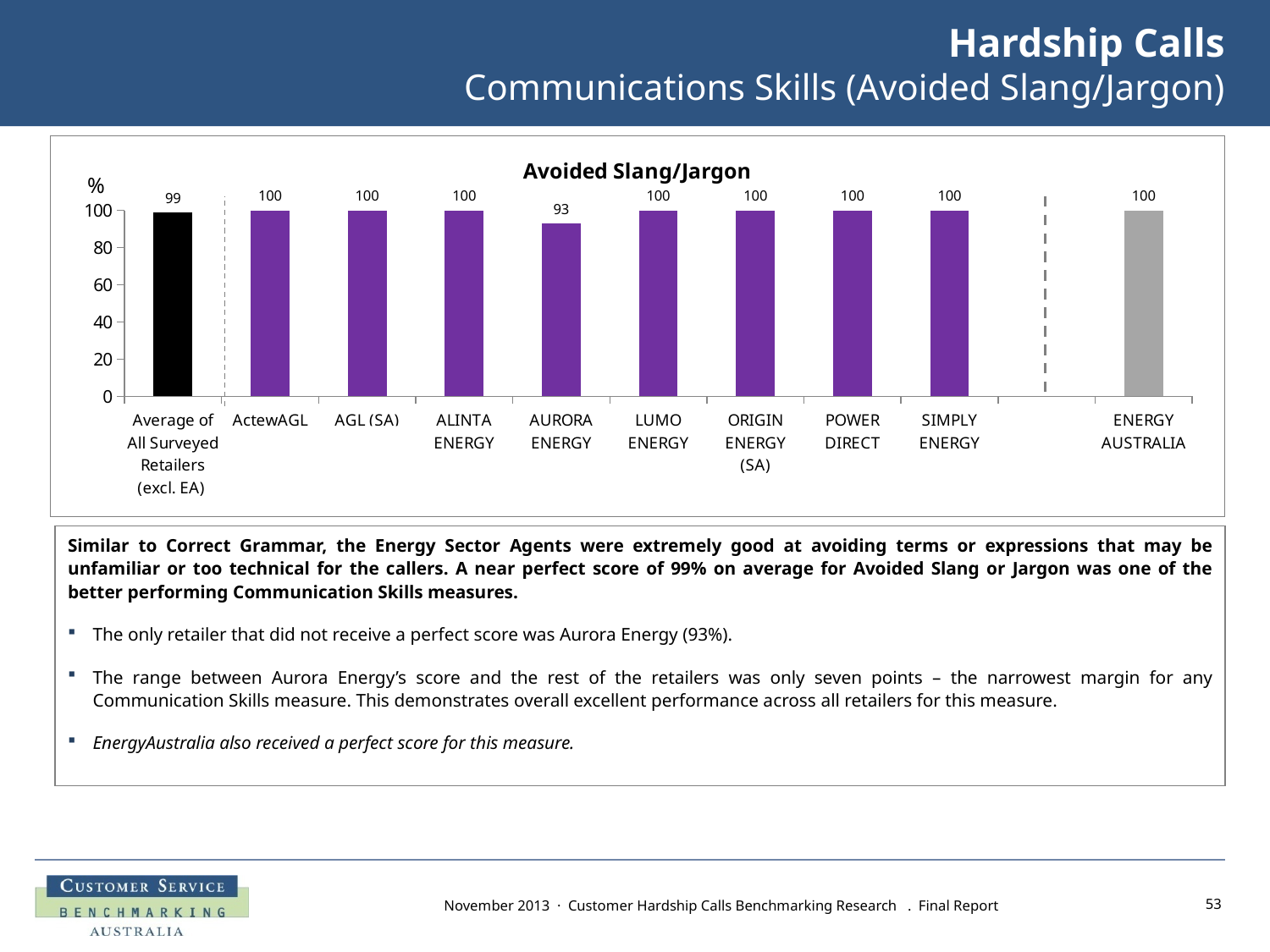
What kind of chart is this? bar chart Which category has the lowest value? AURORA ENERGY How many categories are shown on the x axis? 10 What is the title of the chart? Avoided Slang/Jargon What is the difference between the value for ActewAGL and the value for AURORA ENERGY? 7 What is the value for ActewAGL? 100 What is the value for ENERGY AUSTRALIA? 100 Which is larger, the value for AURORA ENERGY or the value for POWER DIRECT? POWER DIRECT Is the value for AURORA ENERGY greater or less than 80? greater What is the value for AURORA ENERGY? 93 What is the difference between the value for LUMO ENERGY and the Average of All Surveyed Retailers (excl. EA)? 1 What is the value for Average of All Surveyed Retailers (excl. EA)? 99